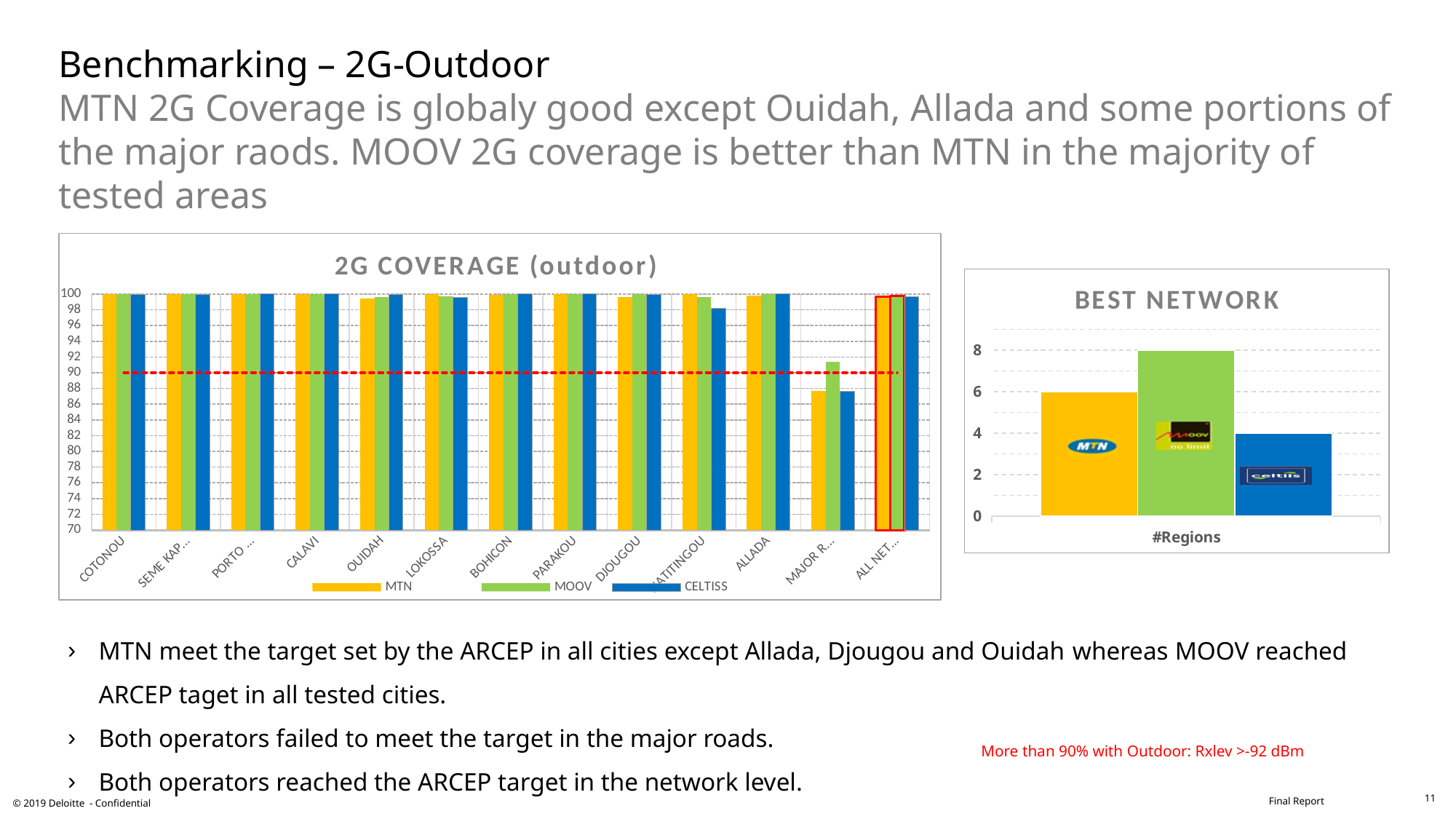
In the 'BEST NETWORK' chart, what is the difference in regions between MOOV and MTN? 2 In the 'BEST NETWORK' chart, which network has the highest number of regions? MOOV How many categories are shown on the x axis of the '2G COVERAGE (outdoor)' chart? 13 What kind of chart is the '2G COVERAGE (outdoor)' chart? bar chart In the 'BEST NETWORK' chart, which network has the lowest number of regions? Celtiis In the '2G COVERAGE (outdoor)' chart, which series is shown in yellow? MTN In the '2G COVERAGE (outdoor)' chart, is the MTN value for COTONOU greater or less than 90? greater How many series does the legend of the '2G COVERAGE (outdoor)' chart list? 3 In the 'BEST NETWORK' chart, which has more regions, MTN or Celtiis? MTN In the '2G COVERAGE (outdoor)' chart, is the MTN value for MAJOR R... greater or less than 90? less In the 'BEST NETWORK' chart, what is the number of regions for MOOV? 8 In the '2G COVERAGE (outdoor)' chart, is the CELTISS value for MAJOR R... greater or less than 90? less